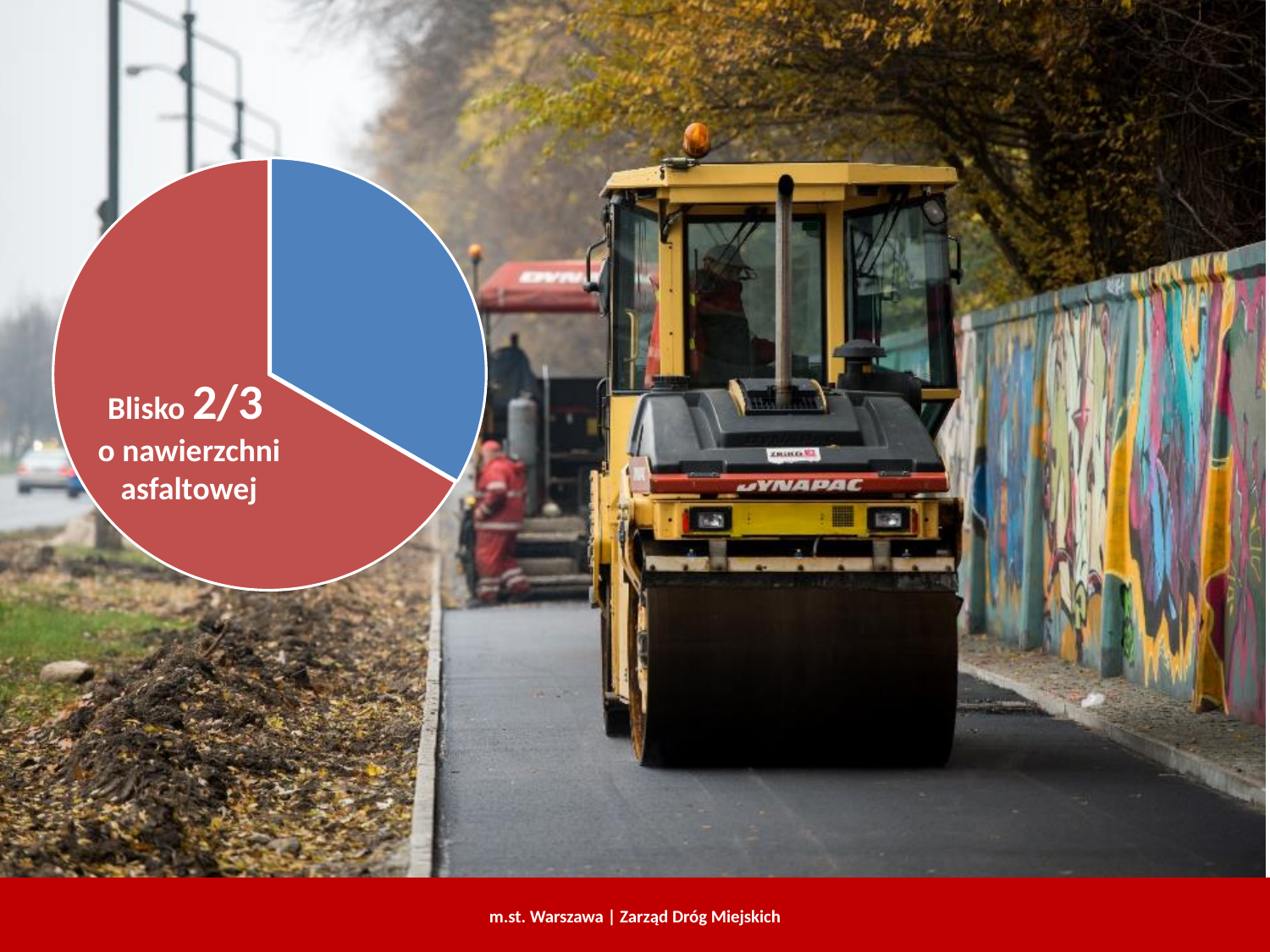
Which colour slice is the smallest in the pie chart? blue Which slice of the pie chart is larger, the red one or the blue one? the red one How many slices does the pie chart have? 2 What kind of chart is shown on the slide? pie chart Is the blue slice of the pie chart greater or less than half of the pie? less What text is written on the red slice of the pie chart? Blisko 2/3 o nawierzchni asfaltowej Is the red slice of the pie chart greater or less than half of the pie? greater According to the text on the pie chart, roughly what fraction has an asphalt surface (nawierzchnia asfaltowa)? Blisko 2/3